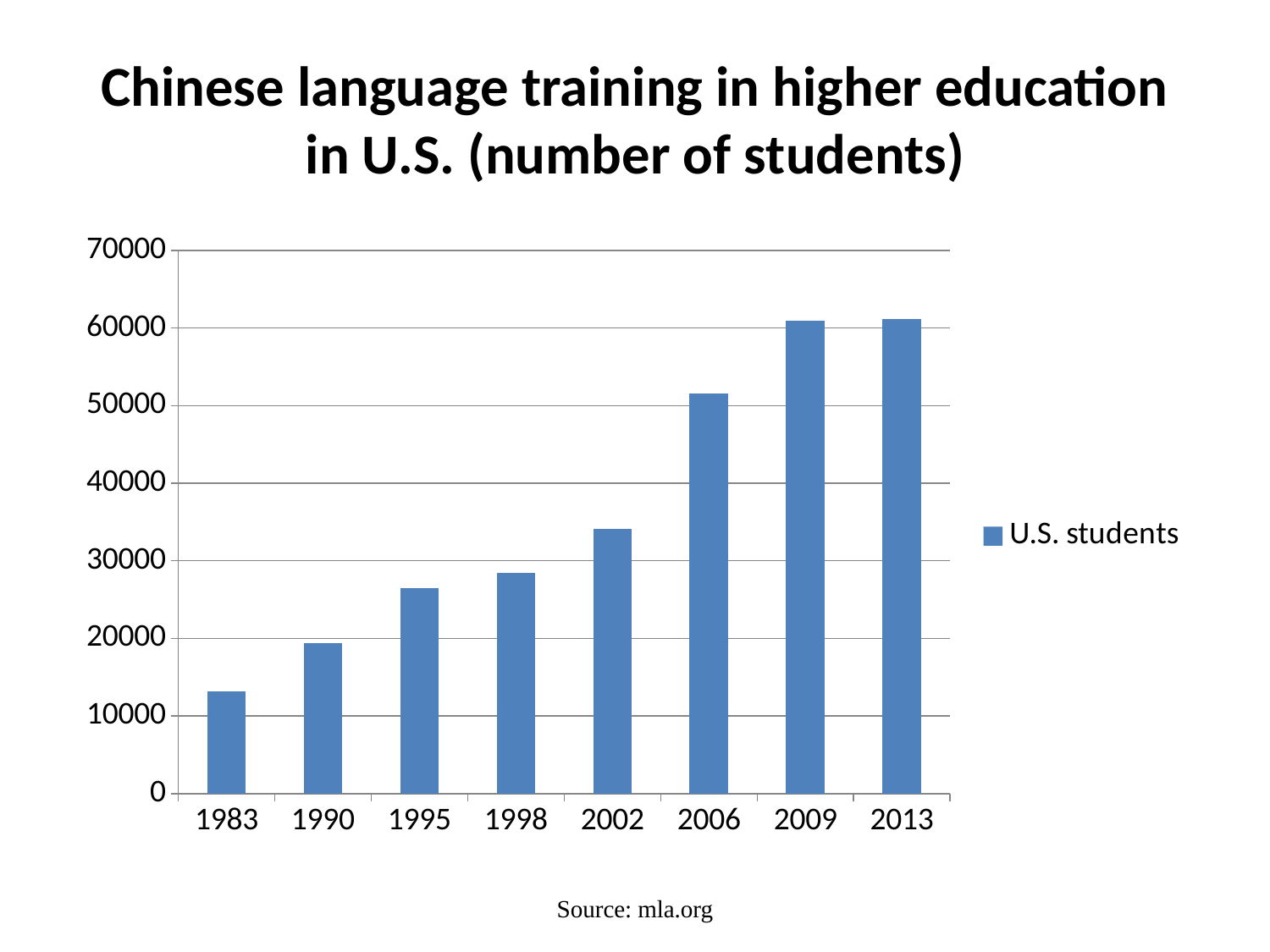
How many series does the legend list? 1 Do the values rise or fall from 1983 to 2013? rise What kind of chart is shown on the slide? bar chart Is the value for 1995 greater or less than 20000? greater Is the value for 1983 greater or less than 10000? greater Is the value for 2002 greater or less than 40000? less How many years are shown on the x axis of the chart? 8 Which year has the lowest number of U.S. students? 1983 Which year has the larger value, 2002 or 2006? 2006